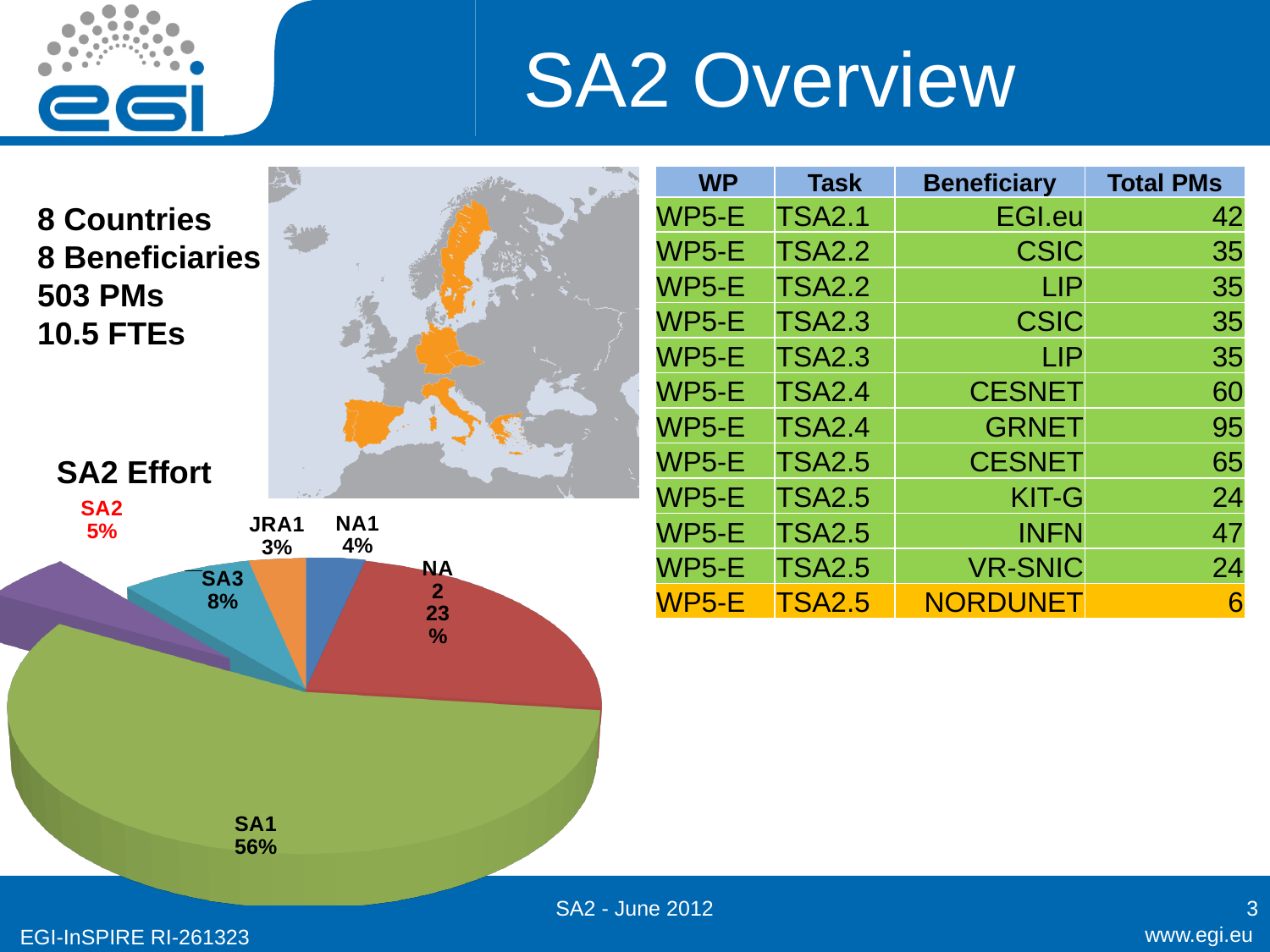
What share of the SA2 Effort pie does NA2 have? 23% In the SA2 Effort pie chart, which is larger, SA3 or NA1? SA3 What share of the SA2 Effort pie does SA1 have? 56% What is the value shown for SA3 in the SA2 Effort pie chart? 8% How many slices does the SA2 Effort pie chart have? 6 Which slice of the SA2 Effort pie chart is the largest? SA1 What kind of chart is the SA2 Effort chart? pie chart What is the value shown for SA2 in the SA2 Effort pie chart? 5% In the SA2 Effort pie chart, what is the difference in percentage points between SA1 and NA2? 33 What is the title of the pie chart on the slide? SA2 Effort What is the value shown for JRA1 in the SA2 Effort pie chart? 3% Which slice of the SA2 Effort pie chart is the smallest? JRA1